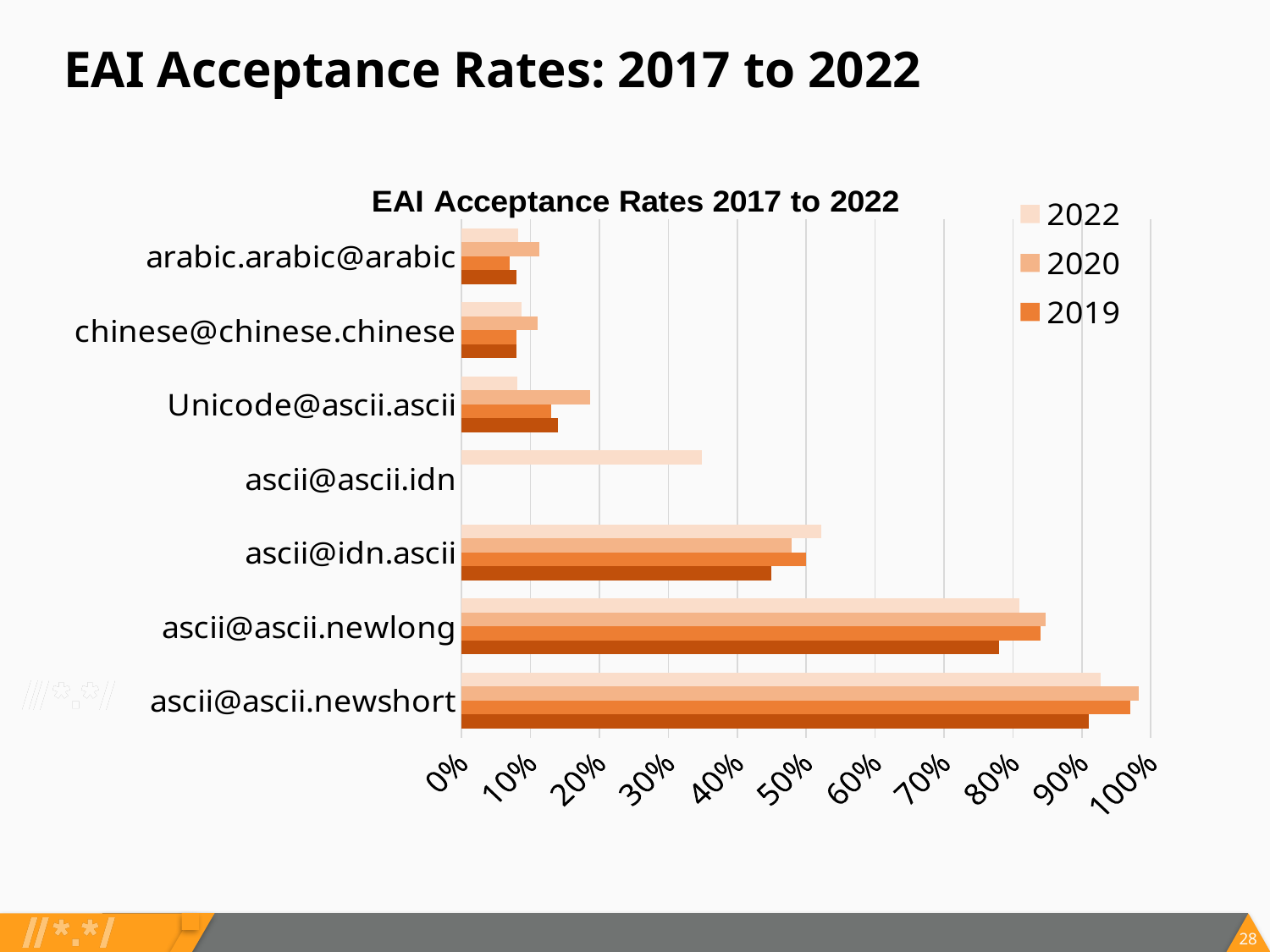
How many series does the legend list? 3 Is the 2019 value for ascii@ascii.newlong greater or less than 80%? greater Is the 2020 value for Unicode@ascii.ascii greater or less than 20%? less Which category has the highest acceptance rate for 2019? ascii@ascii.newshort What kind of chart is shown on the slide? bar chart For 2022, which is larger: the value for ascii@ascii.newlong or the value for ascii@idn.ascii? ascii@ascii.newlong Which years are listed in the legend? 2022, 2020, 2019 Is the 2020 value for ascii@ascii.newshort greater or less than 90%? greater What is the title of the chart? EAI Acceptance Rates 2017 to 2022 Which category has the highest acceptance rate for 2020? ascii@ascii.newshort How many categories are shown on the chart? 7